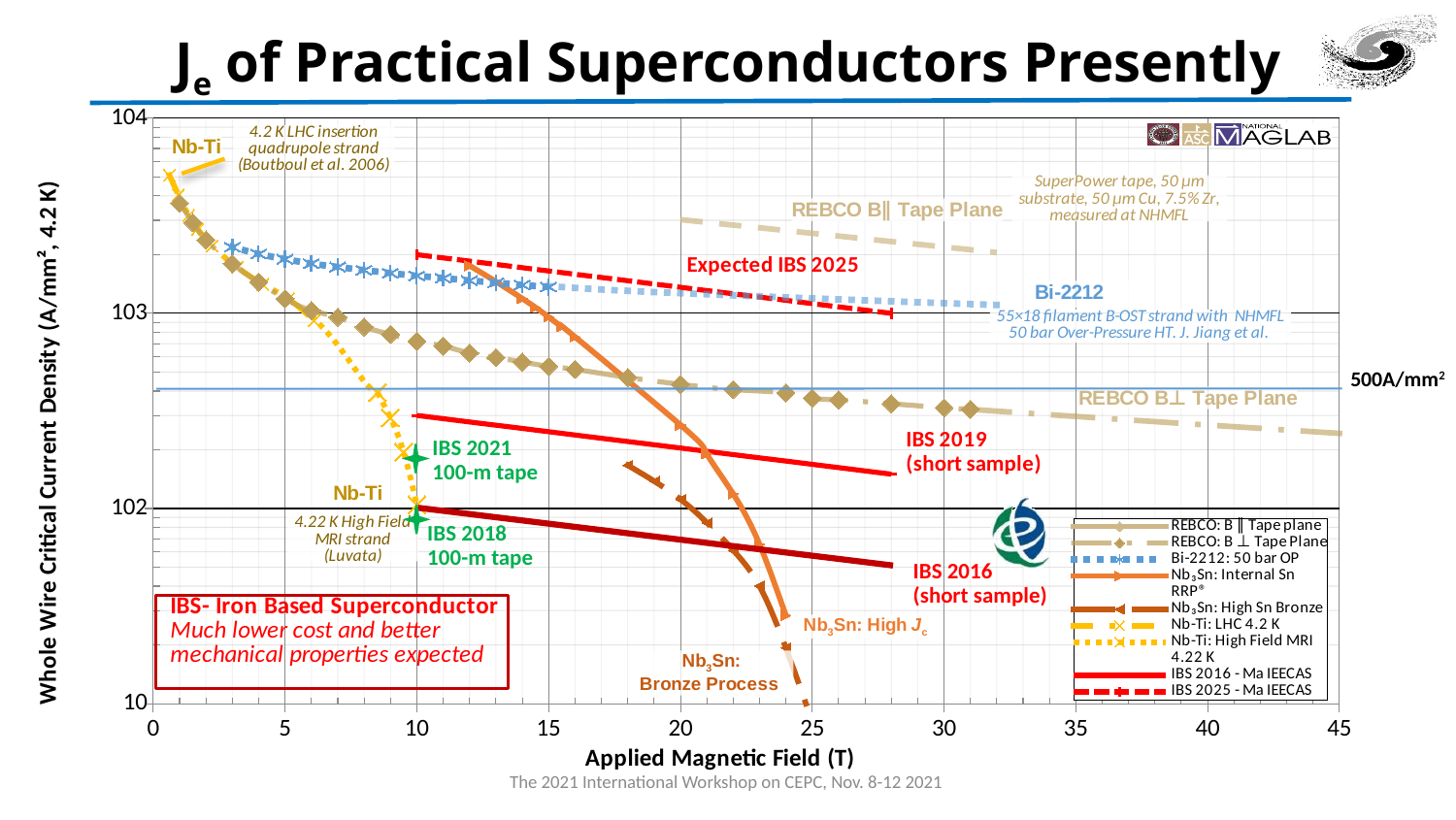
What value is labelled on the horizontal reference line drawn across the chart? 500A/mm² At 20 T, which curve is higher: Expected IBS 2025 or IBS 2019 (short sample)? Expected IBS 2025 At 10 T, which curve is higher: Bi-2212 or Nb-Ti (High Field MRI)? Bi-2212 At 28 T, is the value of the IBS 2016 (short sample) curve greater or less than 10² A/mm²? less What is the largest value shown on the x axis of the chart? 45 How many series does the chart legend list? 9 Which material has the highest critical current density at the lowest applied fields (around 1 T)? Nb-Ti At 10 T, is the value of the Expected IBS 2025 curve greater or less than 10³ A/mm²? greater What kind of chart is shown on the slide? line chart At 20 T, is the value of the REBCO B∥ Tape Plane curve greater or less than 10³ A/mm²? greater Does the Nb-Ti (LHC 4.2 K) curve rise or fall as the applied magnetic field increases? fall What is the title of the x axis of the chart? Applied Magnetic Field (T)